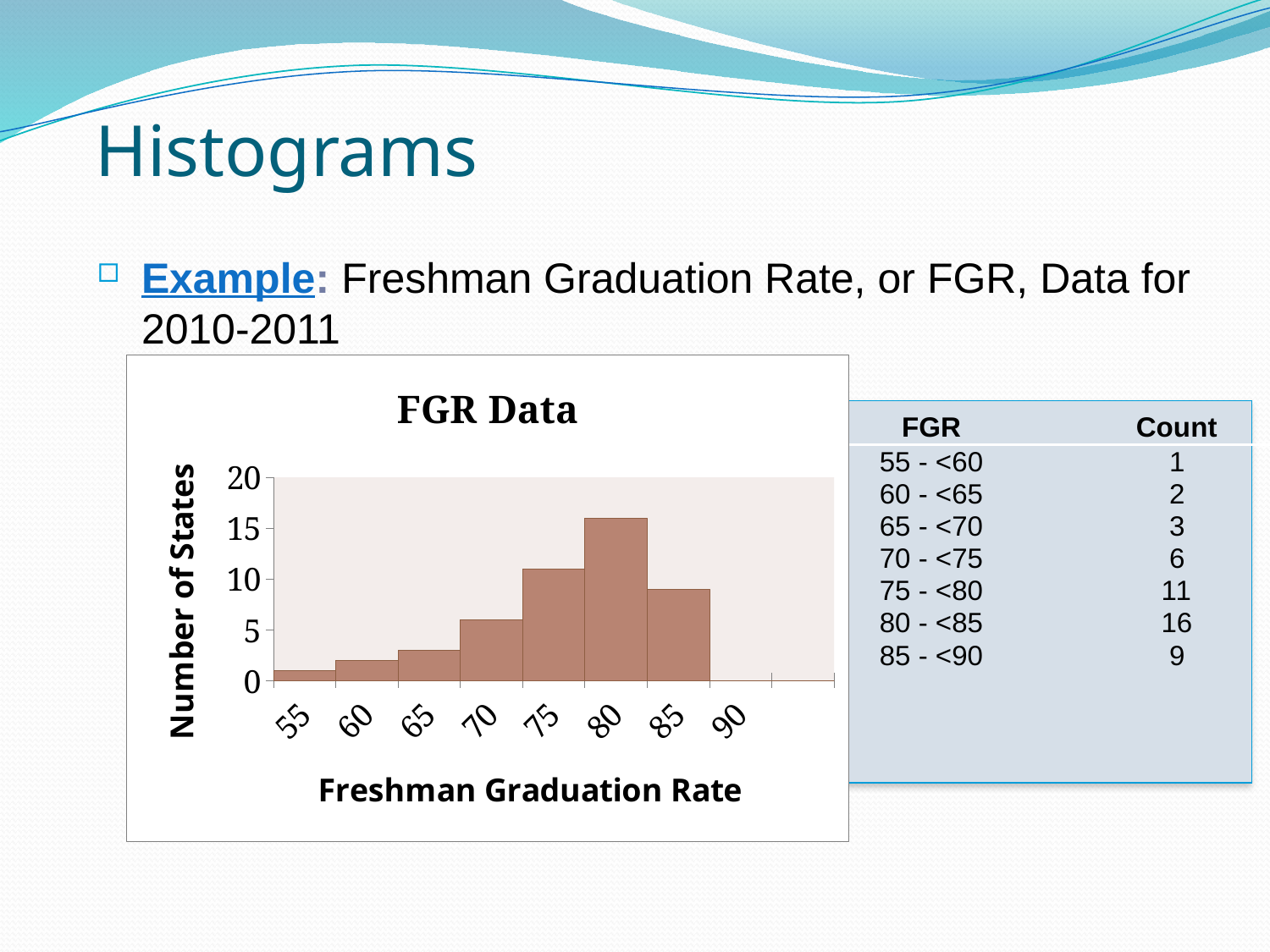
How many FGR bins are shown in the histogram? 7 What is the label of the y axis of the FGR Data chart? Number of States What is the title of the chart? FGR Data Is the number of states in the 75 - <80 bin greater or less than 10? greater What type of chart is the FGR Data chart? bar chart (histogram) How many states have a Freshman Graduation Rate in the 55 - <60 bin? 1 Which bin has more states, 70 - <75 or 85 - <90? 85 - <90 How many states have a Freshman Graduation Rate in the 75 - <80 bin? 11 Which FGR bin has the lowest number of states? 55 - <60 What is the difference in the number of states between the 80 - <85 bin and the 85 - <90 bin? 7 Which FGR bin has the highest number of states? 80 - <85 How many states have a Freshman Graduation Rate in the 80 - <85 bin? 16